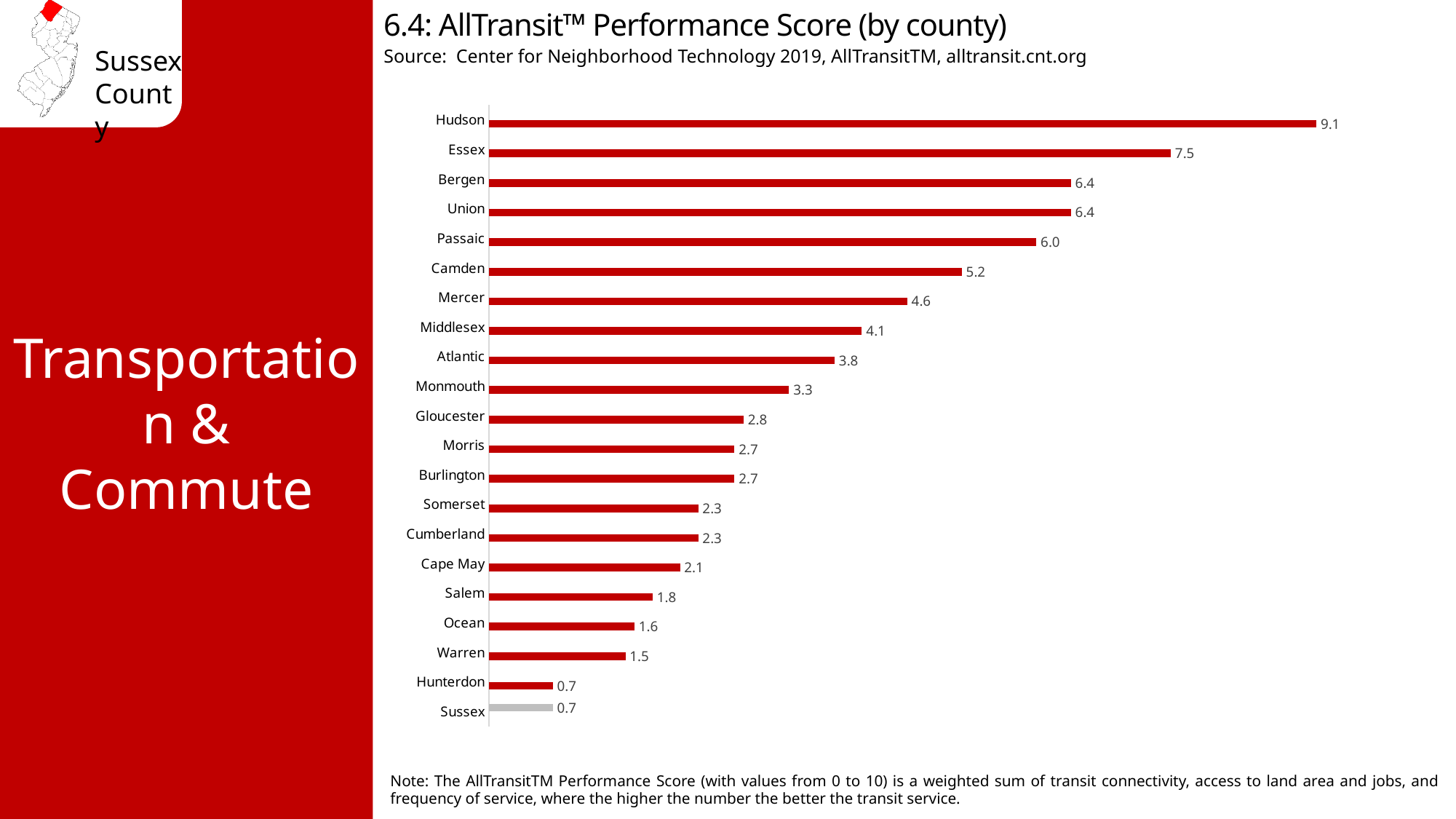
Which county has a higher AllTransit Performance Score, Ocean or Salem? Salem What type of chart is used to show the AllTransit Performance Score by county? Bar chart Which county's bar is shown in a different colour (grey) from the others? Sussex What is the AllTransit Performance Score for Monmouth county? 3.3 What is the difference between the AllTransit Performance Scores of Passaic and Sussex? 5.3 How many counties are shown in the chart? 21 What is the difference between the AllTransit Performance Scores of Hudson and Essex? 1.6 What is the AllTransit Performance Score for Camden county? 5.2 Which county has a higher AllTransit Performance Score, Mercer or Middlesex? Mercer What is the AllTransit Performance Score for Sussex county? 0.7 Which county has the highest AllTransit Performance Score? Hudson What is the AllTransit Performance Score for Hudson county? 9.1